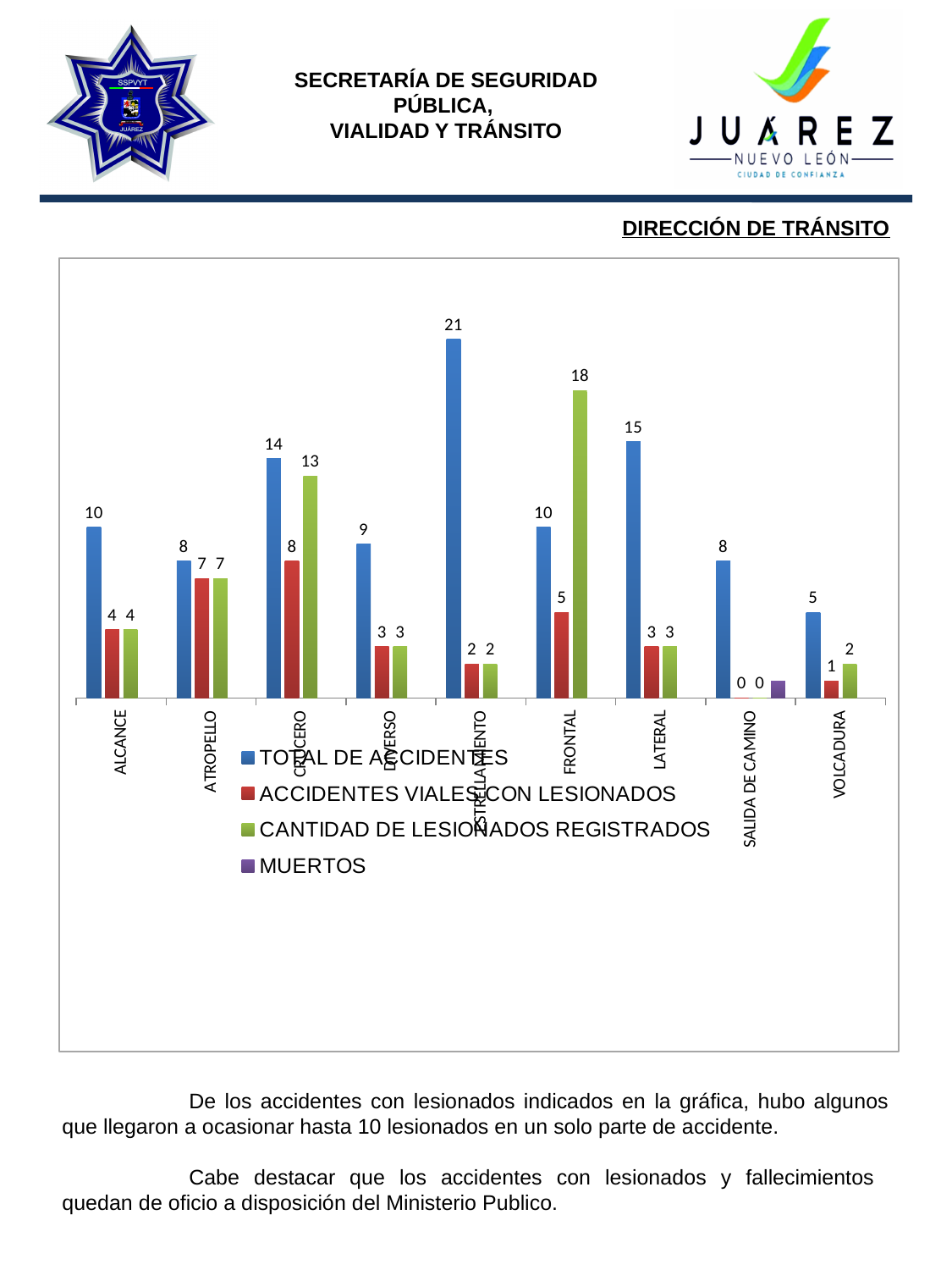
Which has a higher TOTAL DE ACCIDENTES, CRUCERO or LATERAL? LATERAL For ALCANCE, what is the difference between TOTAL DE ACCIDENTES and ACCIDENTES VIALES CON LESIONADOS? 6 Which category has the highest value for CANTIDAD DE LESIONADOS REGISTRADOS? FRONTAL For FRONTAL, what is the difference between CANTIDAD DE LESIONADOS REGISTRADOS and TOTAL DE ACCIDENTES? 8 How many series does the legend list? 4 What is the value of ACCIDENTES VIALES CON LESIONADOS for SALIDA DE CAMINO? 0 What is the value of CANTIDAD DE LESIONADOS REGISTRADOS for CRUCERO? 13 What is the value of TOTAL DE ACCIDENTES for LATERAL? 15 Which category has the lowest value for TOTAL DE ACCIDENTES? VOLCADURA What is the value of ACCIDENTES VIALES CON LESIONADOS for FRONTAL? 5 How many categories are shown on the x axis of the chart? 9 What kind of chart is shown on the slide? Bar chart